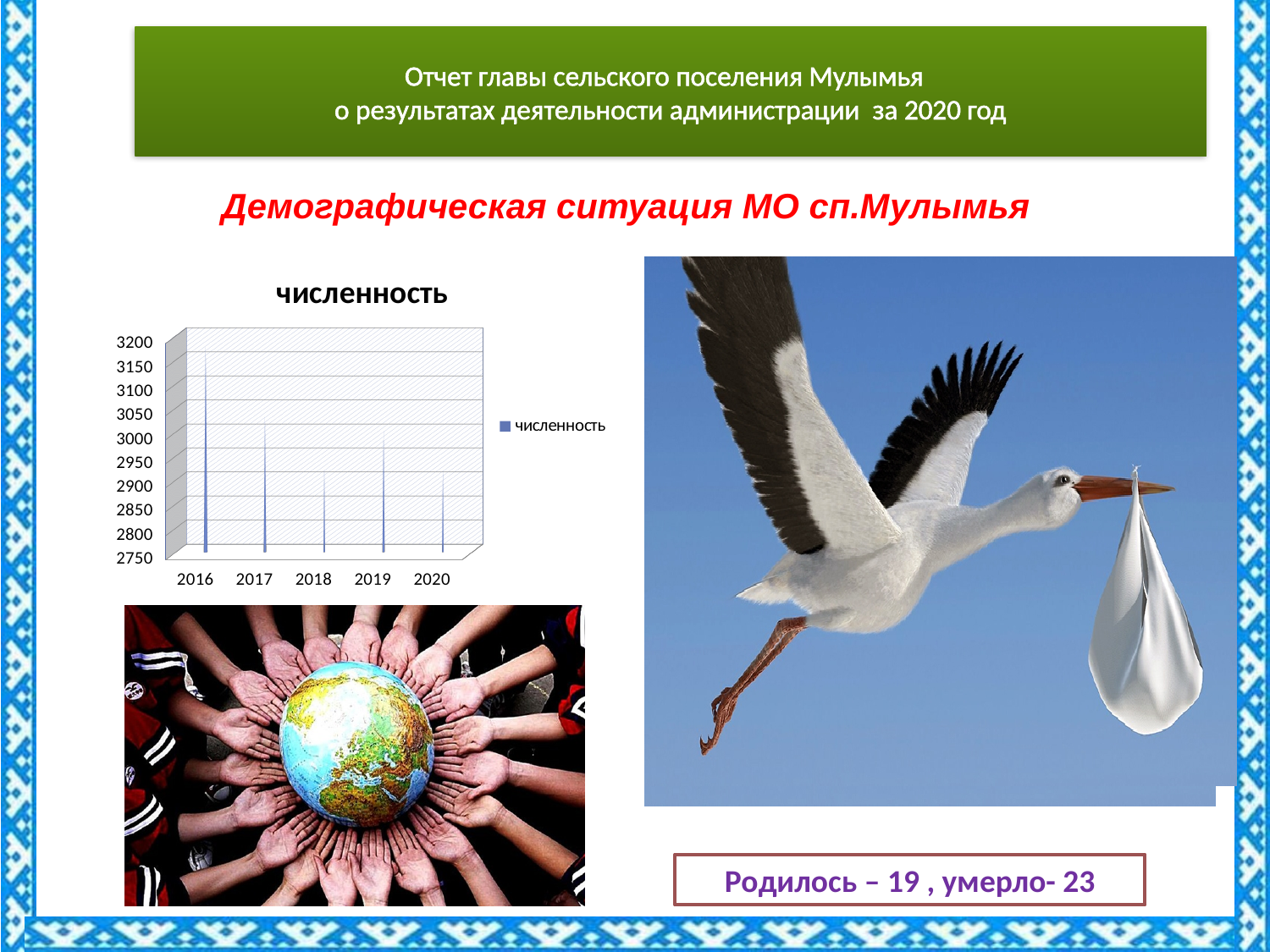
Is the value for 2019 greater or less than 2950? greater Which year has the highest value in the chart? 2016 How many years are shown on the x axis of the chart? 5 Which is larger, the value for 2017 or the value for 2018? 2017 What is the title of the chart? численность Is the value for 2018 greater or less than 2950? less Is the value for 2016 greater or less than 3100? greater How many series does the chart legend list? 1 What kind of chart is shown on the slide? bar chart Overall, do the values rise or fall from 2016 to 2020? fall Which is larger, the value for 2016 or the value for 2020? 2016